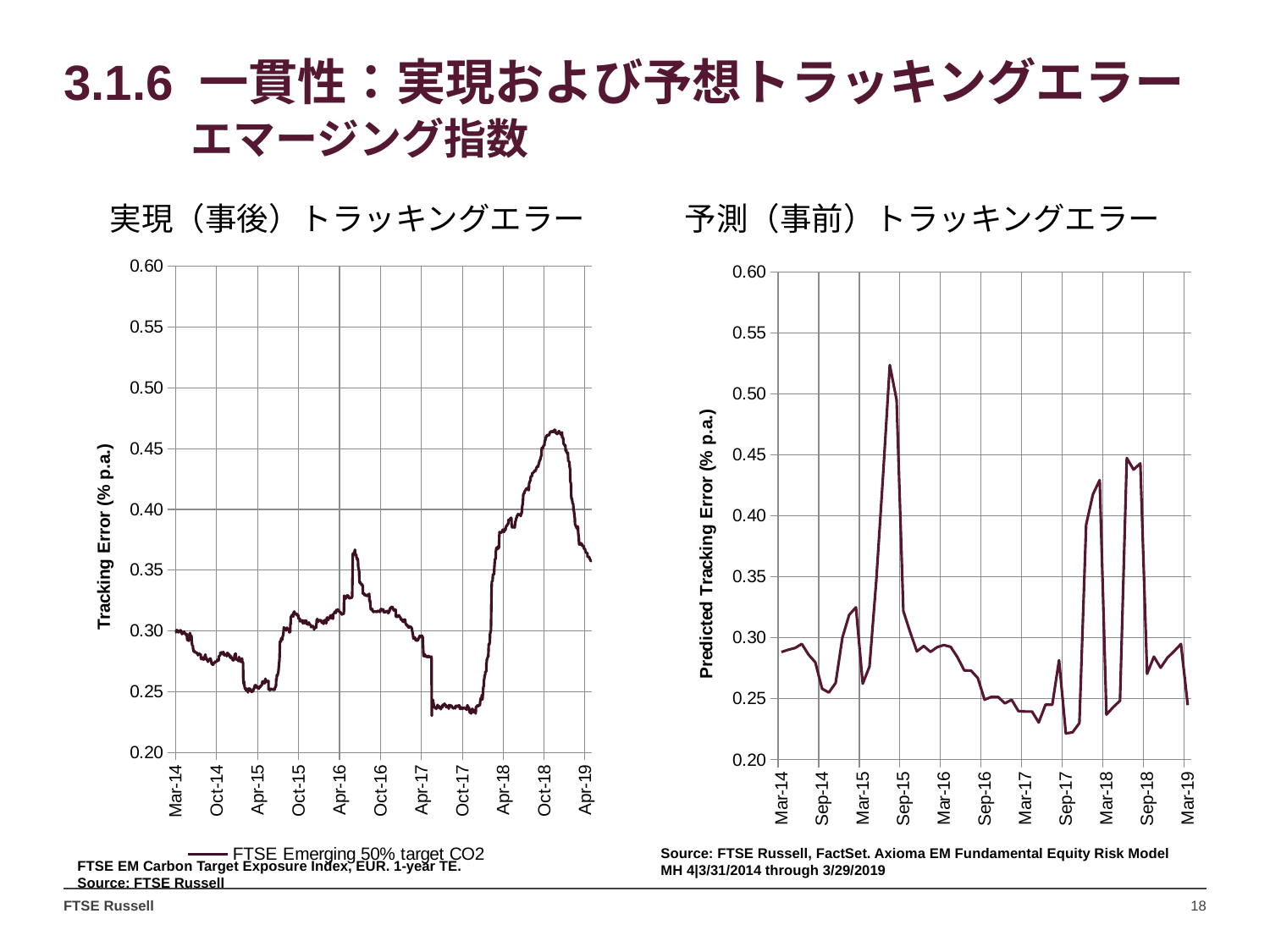
In the left chart (実現（事後）トラッキングエラー), which is larger: the value at Oct-18 or the value at Apr-15? Oct-18 In the left chart (実現（事後）トラッキングエラー), is the value at Apr-16 greater or less than 0.30? greater In the left chart (実現（事後）トラッキングエラー), how many series does the legend list? 1 In the left chart (実現（事後）トラッキングエラー), is the value at Oct-18 greater or less than 0.40? greater In the left chart (実現（事後）トラッキングエラー), what is the name of the series shown in the legend? FTSE Emerging 50% target CO2 In the left chart (実現（事後）トラッキングエラー), is the value at Oct-17 greater or less than 0.25? less What type of chart is the right chart titled 予測（事前）トラッキングエラー? line chart What is the y-axis title of the right chart (予測（事前）トラッキングエラー)? Predicted Tracking Error (% p.a.) In the right chart (予測（事前）トラッキングエラー), around which x-axis label does the line reach its highest value? Sep-15 What type of chart is the left chart titled 実現（事後）トラッキングエラー? line chart